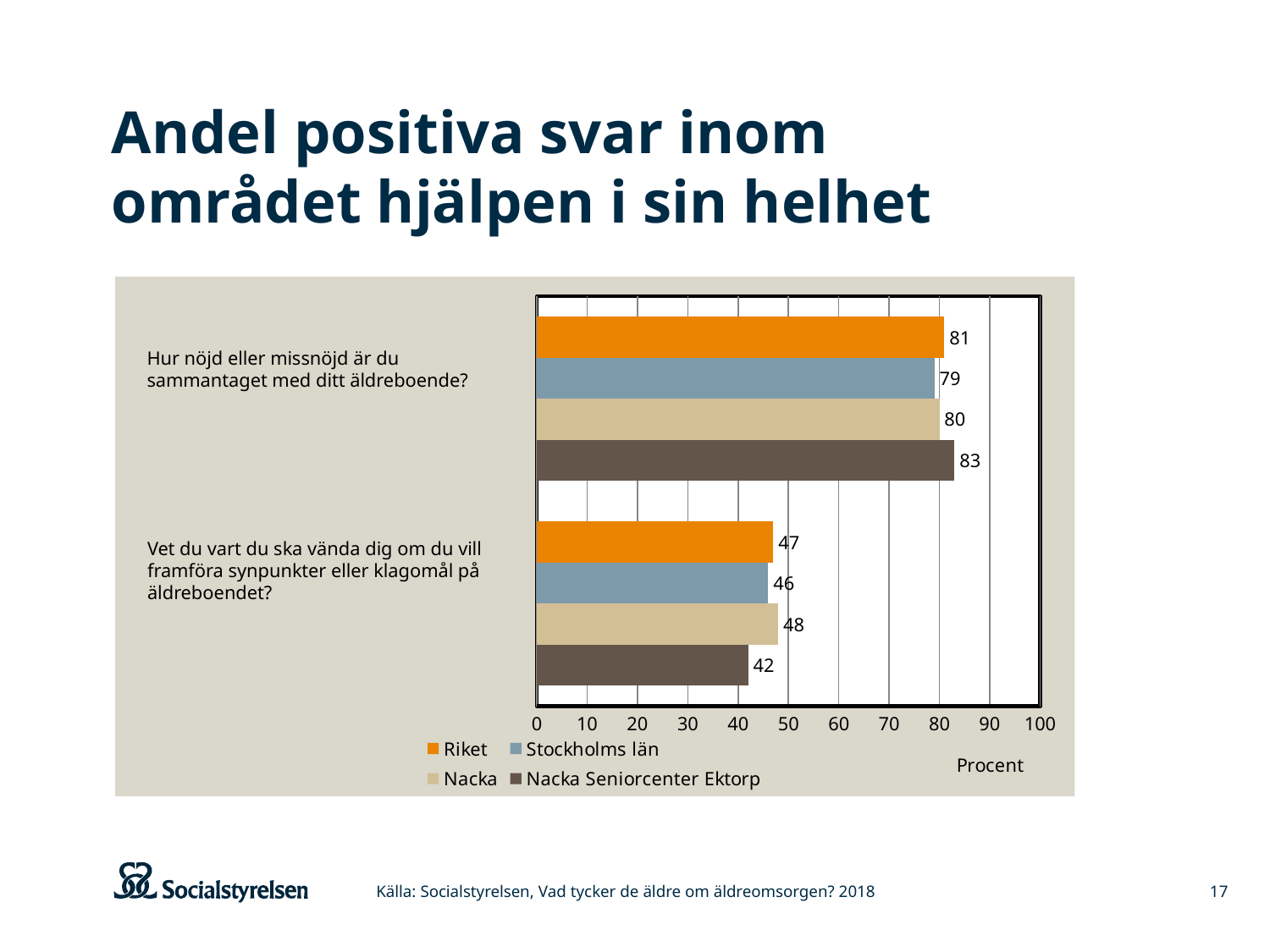
Which series has the highest value for the question "Hur nöjd eller missnöjd är du sammantaget med ditt äldreboende?"? Nacka Seniorcenter Ektorp For the question "Vet du vart du ska vända dig om du vill framföra synpunkter eller klagomål på äldreboendet?", which is larger: the value for Nacka or the value for Nacka Seniorcenter Ektorp? Nacka What is the value for Nacka Seniorcenter Ektorp for the question "Hur nöjd eller missnöjd är du sammantaget med ditt äldreboende?"? 83 Is the value for Riket for the question "Vet du vart du ska vända dig om du vill framföra synpunkter eller klagomål på äldreboendet?" greater or less than 50? less What is the difference between the Nacka Seniorcenter Ektorp value and the Stockholms län value for the question "Hur nöjd eller missnöjd är du sammantaget med ditt äldreboende?"? 4 How many series does the legend list? 4 What is the label on the horizontal axis of the chart? Procent How many questions (categories) are shown on the chart? 2 Which series has the lowest value for the question "Vet du vart du ska vända dig om du vill framföra synpunkter eller klagomål på äldreboendet?"? Nacka Seniorcenter Ektorp What is the value for Riket for the question "Hur nöjd eller missnöjd är du sammantaget med ditt äldreboende?"? 81 What kind of chart is shown on the slide? Bar chart What is the value for Stockholms län for the question "Vet du vart du ska vända dig om du vill framföra synpunkter eller klagomål på äldreboendet?"? 46